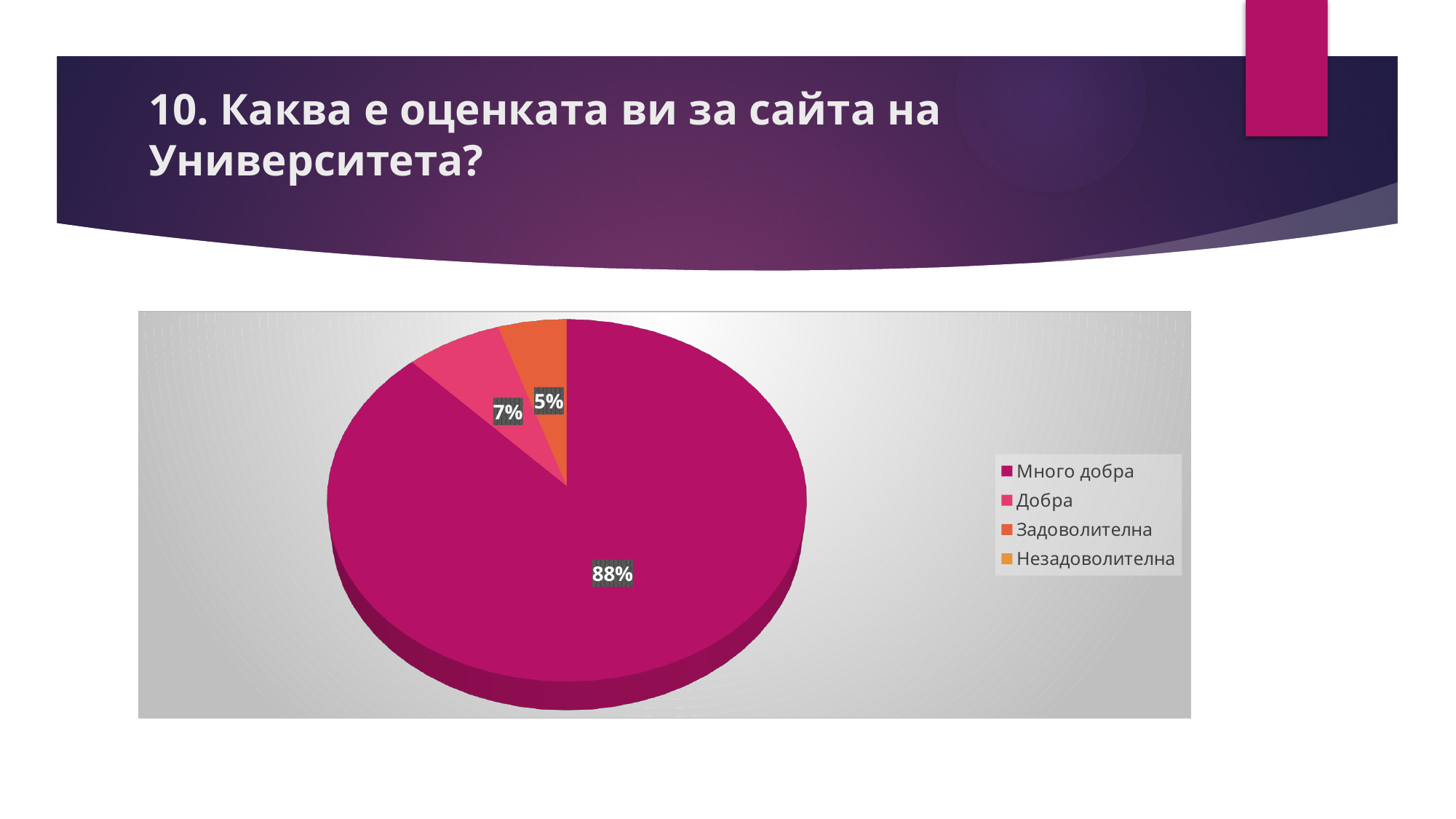
What is the difference in percentage points between the "Добра" slice and the "Задоволителна" slice? 2 Which slice is larger, "Добра" or "Задоволителна"? Добра Which category has the largest slice of the pie? Много добра What is the title of the slide containing the pie chart? 10. Каква е оценката ви за сайта на Университета? How many entries does the legend list? 4 What share of the pie does "Задоволителна" take? 5% What is the difference in percentage points between the "Много добра" slice and the "Добра" slice? 81 What kind of chart is shown on the slide? pie chart What share of the pie does "Много добра" take? 88% What share of the pie does "Добра" take? 7% Which of the labelled slices is the smallest? Задоволителна